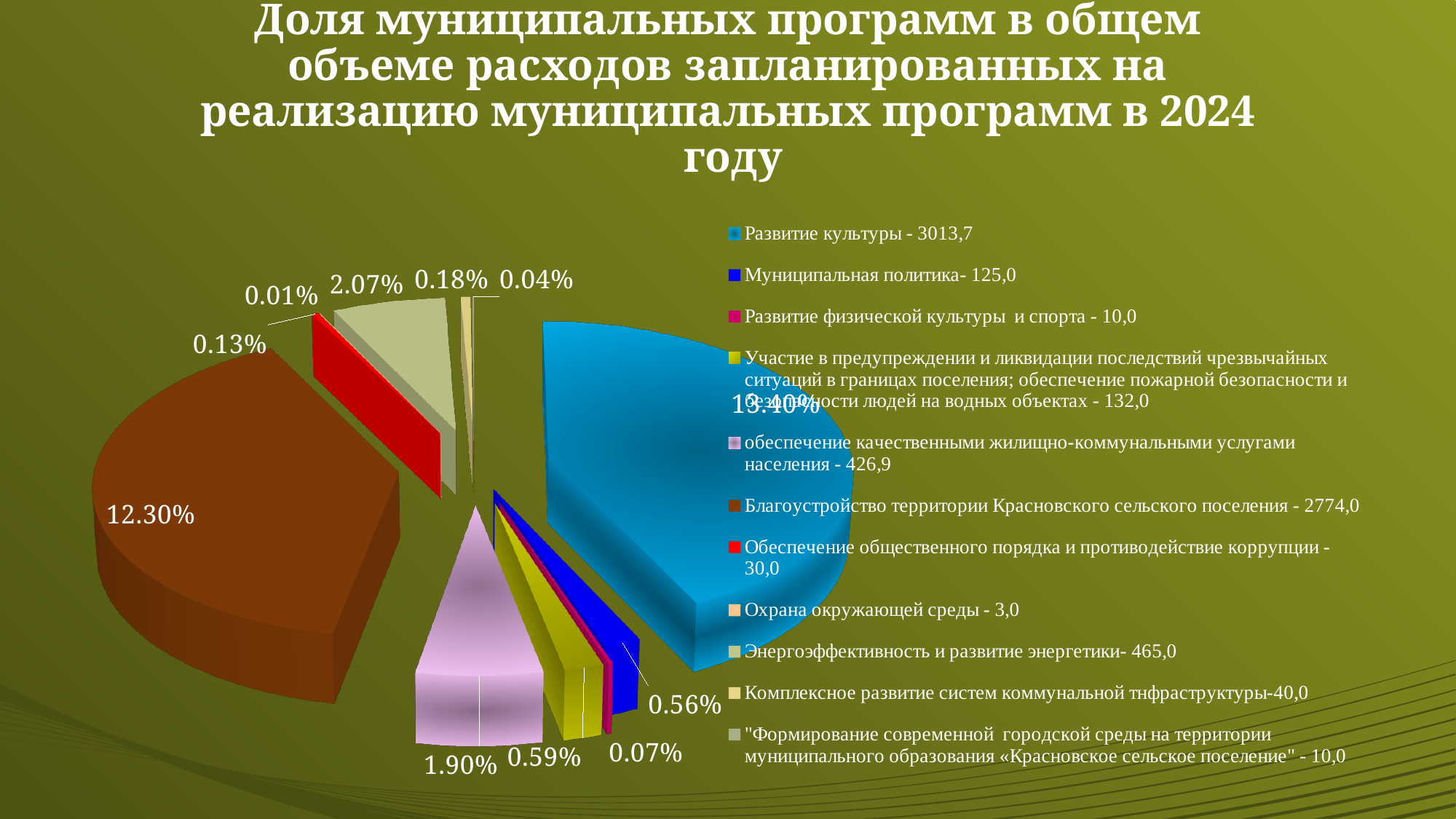
How many categories does the legend of the pie chart list? 11 What is the difference in percentage points between the "Развитие культуры" slice (13.40%) and the "Благоустройство территории Красновского сельского поселения" slice (12.30%)? 1.10% What amount is given in the legend next to "Муниципальная политика"? 125,0 What kind of chart is shown on the slide? pie chart Which category has the largest slice of the pie? Развитие культуры Which category has the smallest percentage label on the pie? Охрана окружающей среды What percentage is shown for the slice "Развитие культуры"? 13.40% Which slice is larger: "Развитие культуры" or "Благоустройство территории Красновского сельского поселения"? Развитие культуры What percentage is shown for the slice "Благоустройство территории Красновского сельского поселения"? 12.30% What percentage is shown for the slice "Энергоэффективность и развитие энергетики"? 2.07% What percentage is shown for the slice "обеспечение качественными жилищно-коммунальными услугами населения"? 1.90% What amount is given in the legend next to "Развитие культуры"? 3013,7